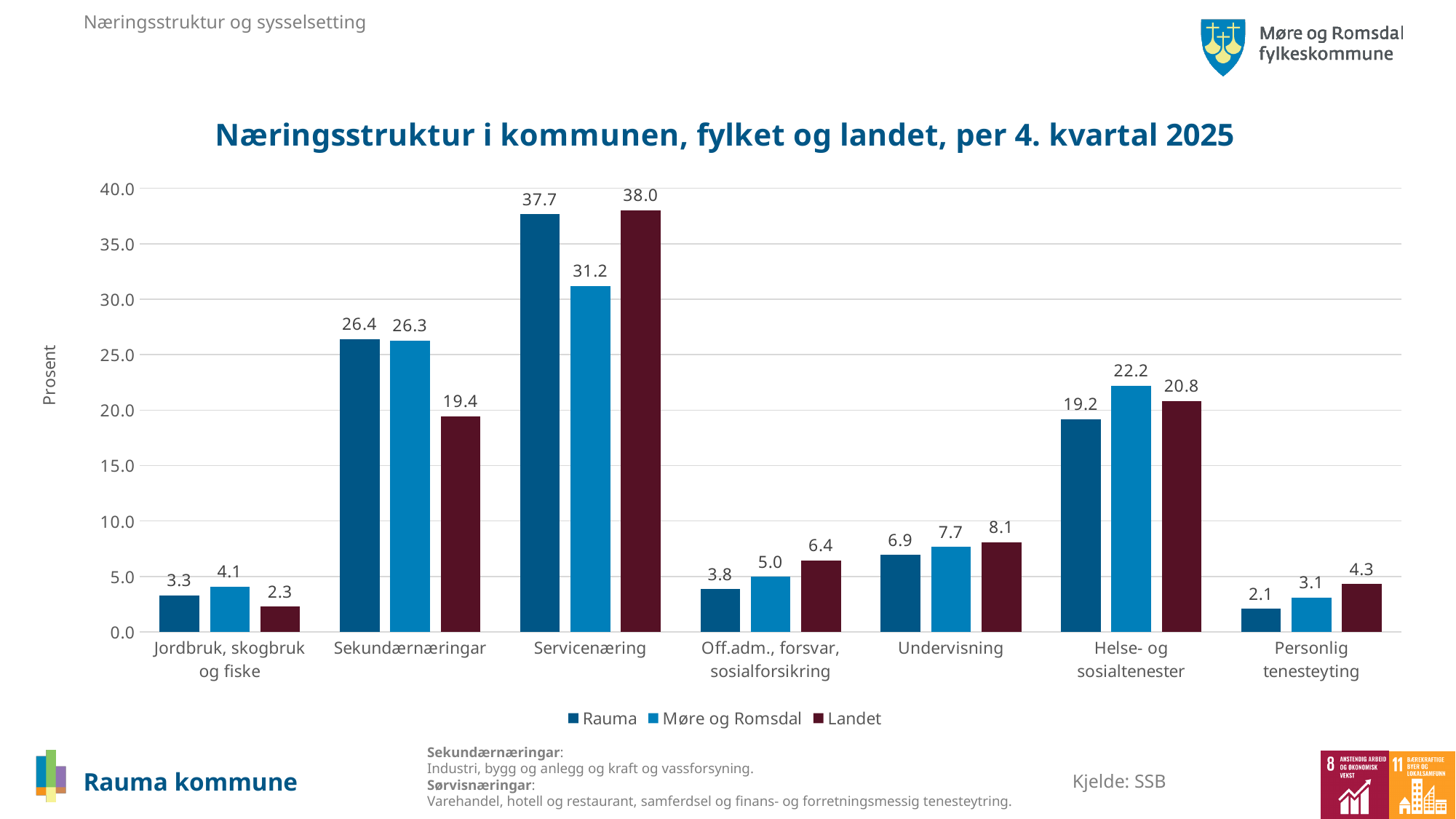
What kind of chart is this? Bar chart What is the difference between Rauma and Landet in Sekundærnæringar? 7.0 What is the value for Rauma in Servicenæring? 37.7 What is the title of the chart? Næringsstruktur i kommunen, fylket og landet, per 4. kvartal 2025 Which category has the highest value for Landet? Servicenæring How many series does the legend list? 3 Which category has the lowest value for Rauma? Personlig tenesteyting How many categories are shown on the x axis? 7 What is the value for Landet in Sekundærnæringar? 19.4 What is the difference between Møre og Romsdal and Rauma in Off.adm., forsvar, sosialforsikring? 1.2 What is the value for Møre og Romsdal in Helse- og sosialtenester? 22.2 Which is larger in Undervisning: Rauma or Landet? Landet